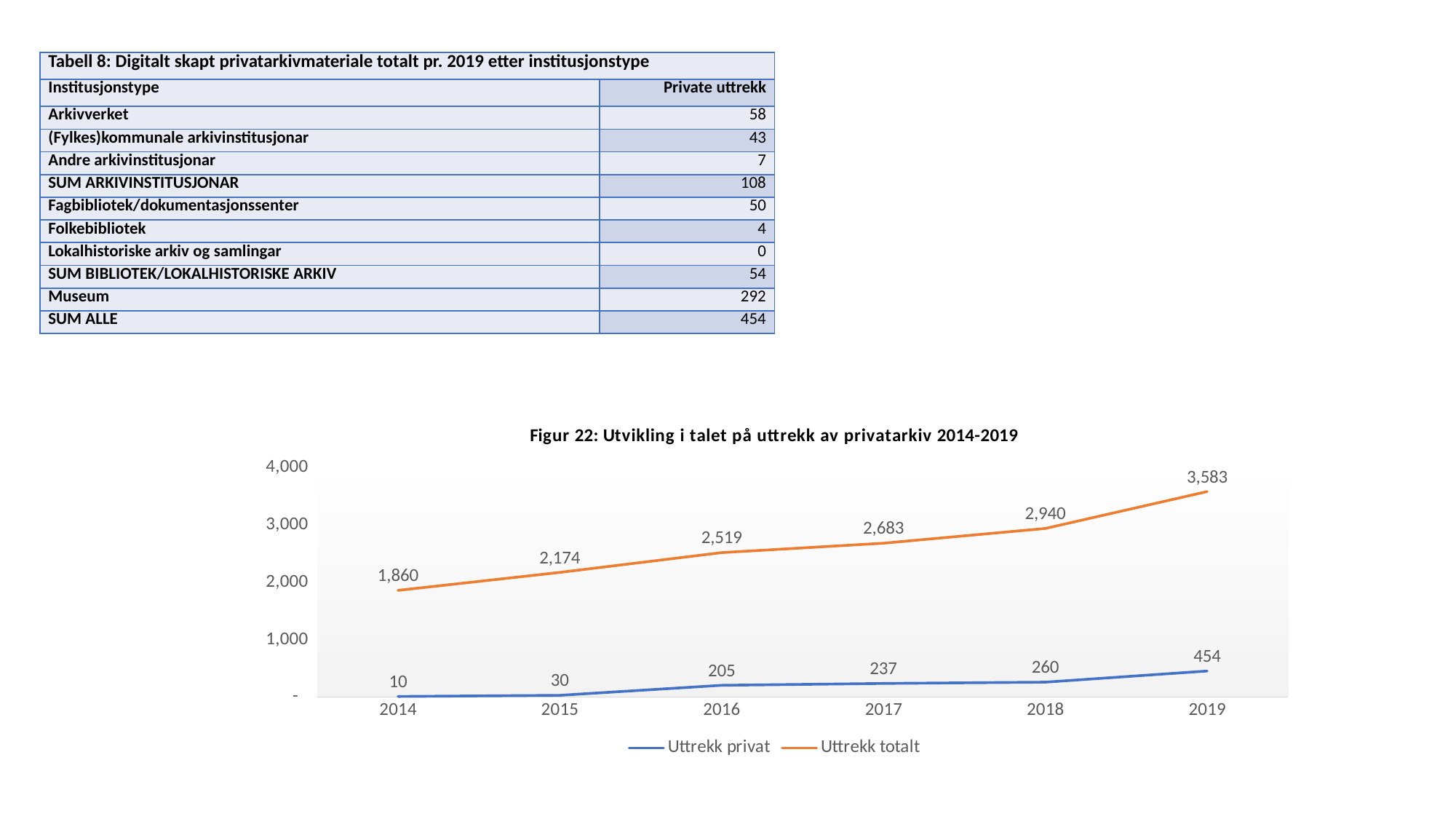
In Figur 22, is Uttrekk totalt in 2017 greater or less than 3,000? less In Figur 22, which year has the lowest value for Uttrekk privat? 2014 In Figur 22, what is the value of Uttrekk totalt in 2019? 3,583 In Figur 22, what is the difference between Uttrekk privat in 2019 and in 2018? 194 What type of chart is Figur 22? line chart How many series does the legend of Figur 22 list? 2 In Figur 22, what is the value of Uttrekk privat in 2016? 205 In Figur 22, what is the difference between Uttrekk totalt in 2019 and in 2018? 643 In Figur 22, does Uttrekk totalt rise or fall from 2014 to 2019? rise In Figur 22, which year has the highest value for Uttrekk totalt? 2019 In Figur 22, what is the value of Uttrekk totalt in 2014? 1,860 How many years are plotted on the x axis of Figur 22? 6